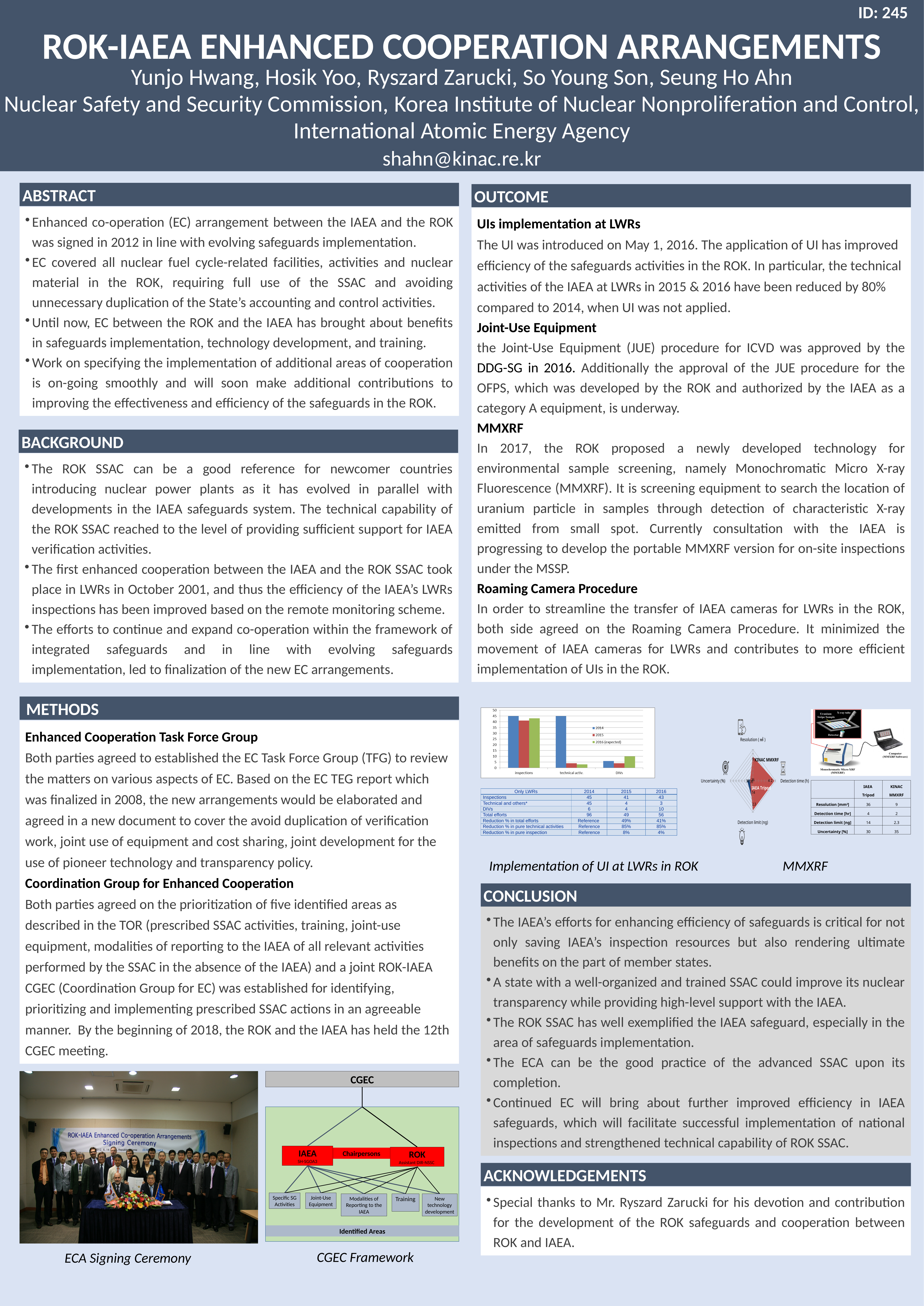
In the 'Implementation of UI at LWRs in ROK' chart, how many categories are shown on the x axis? 3 In the 'Implementation of UI at LWRs in ROK' chart, which series has the highest value for technical activ.? 2014 In the 'Implementation of UI at LWRs in ROK' chart, which is larger for technical activ.: the 2014 value or the 2015 value? 2014 In the 'Implementation of UI at LWRs in ROK' chart, is the 2015 value for technical activ. greater or less than 10? less In the 'Implementation of UI at LWRs in ROK' chart, is the 2016 (expected) value for inspections greater or less than 35? greater What kind of chart is the 'Implementation of UI at LWRs in ROK' chart? bar chart In the 'Implementation of UI at LWRs in ROK' chart, what colour are the 2014 bars? blue In the 'Implementation of UI at LWRs in ROK' chart, what are the three legend entries? 2014, 2015, 2016 (expected) In the 'Implementation of UI at LWRs in ROK' chart, is the 2014 value for DIVs greater or less than 10? less In the 'Implementation of UI at LWRs in ROK' chart, how many series does the legend list? 3 In the 'Implementation of UI at LWRs in ROK' chart, which category has the lowest 2014 value? DIVs